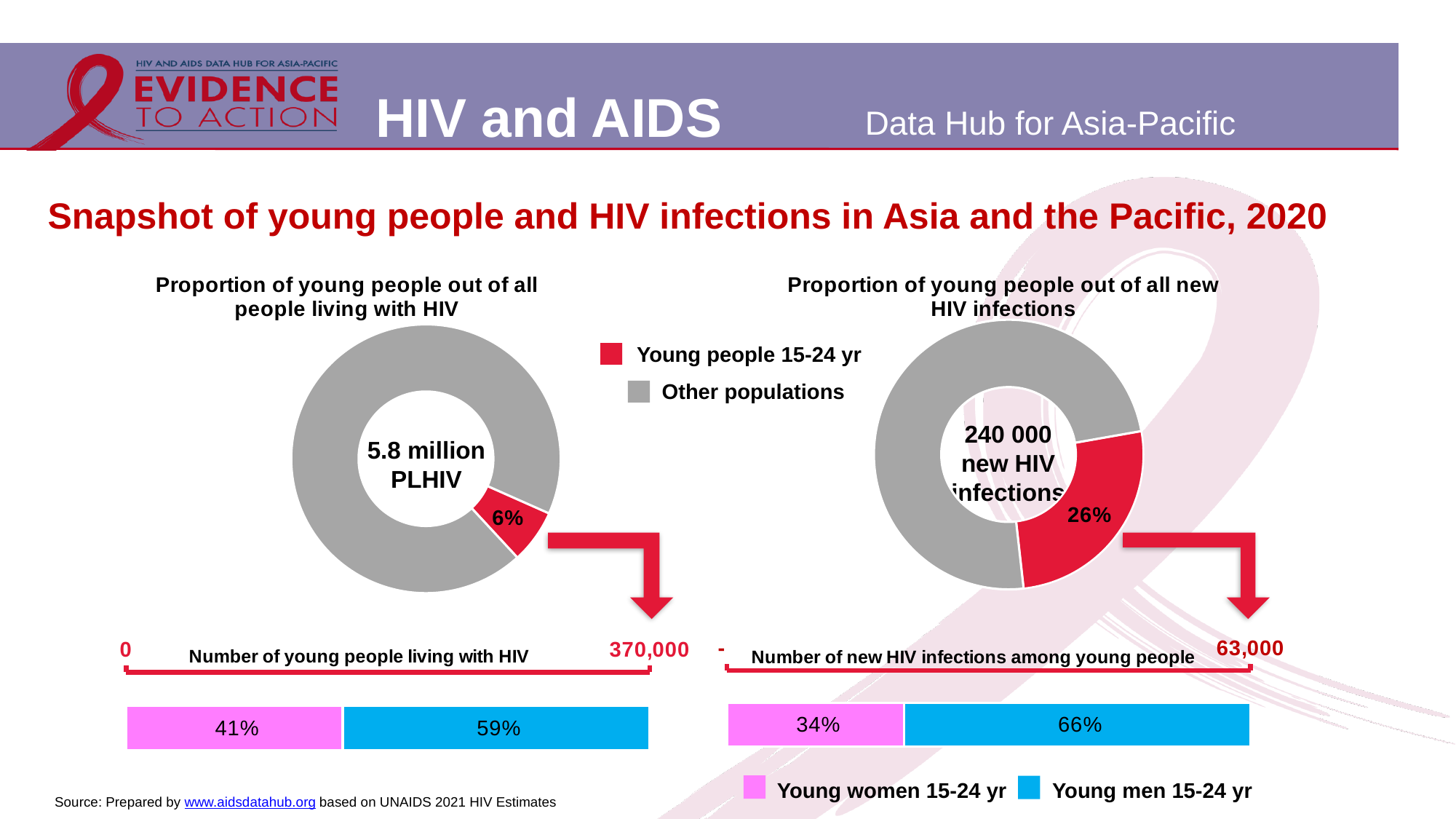
In the bottom-right stacked bar on new HIV infections among young people, what percentage is young men 15-24 yr? 66% In the donut chart 'Proportion of young people out of all people living with HIV', what percentage is shown for young people 15-24 yr? 6% What is the number of new HIV infections among young people shown at the end of the bottom-right bar? 63,000 Which donut chart shows a larger share for young people 15-24 yr: the one for all people living with HIV or the one for all new HIV infections? All new HIV infections In the bottom-left stacked bar on young people living with HIV, what percentage is young women 15-24 yr? 41% What total is printed in the centre of the right donut chart on new HIV infections? 240 000 new HIV infections In the bottom-left stacked bar on young people living with HIV, how many percentage points higher is the young men share than the young women share? 18 percentage points In the donut chart 'Proportion of young people out of all new HIV infections', what percentage is shown for young people 15-24 yr? 26% How many entries does the legend for the two donut charts list? 2 What is the number of young people living with HIV shown at the end of the bottom-left bar? 370,000 What kind of chart is used to show the proportion of young people out of all people living with HIV? Donut (pie) chart What total is printed in the centre of the left donut chart on people living with HIV? 5.8 million PLHIV